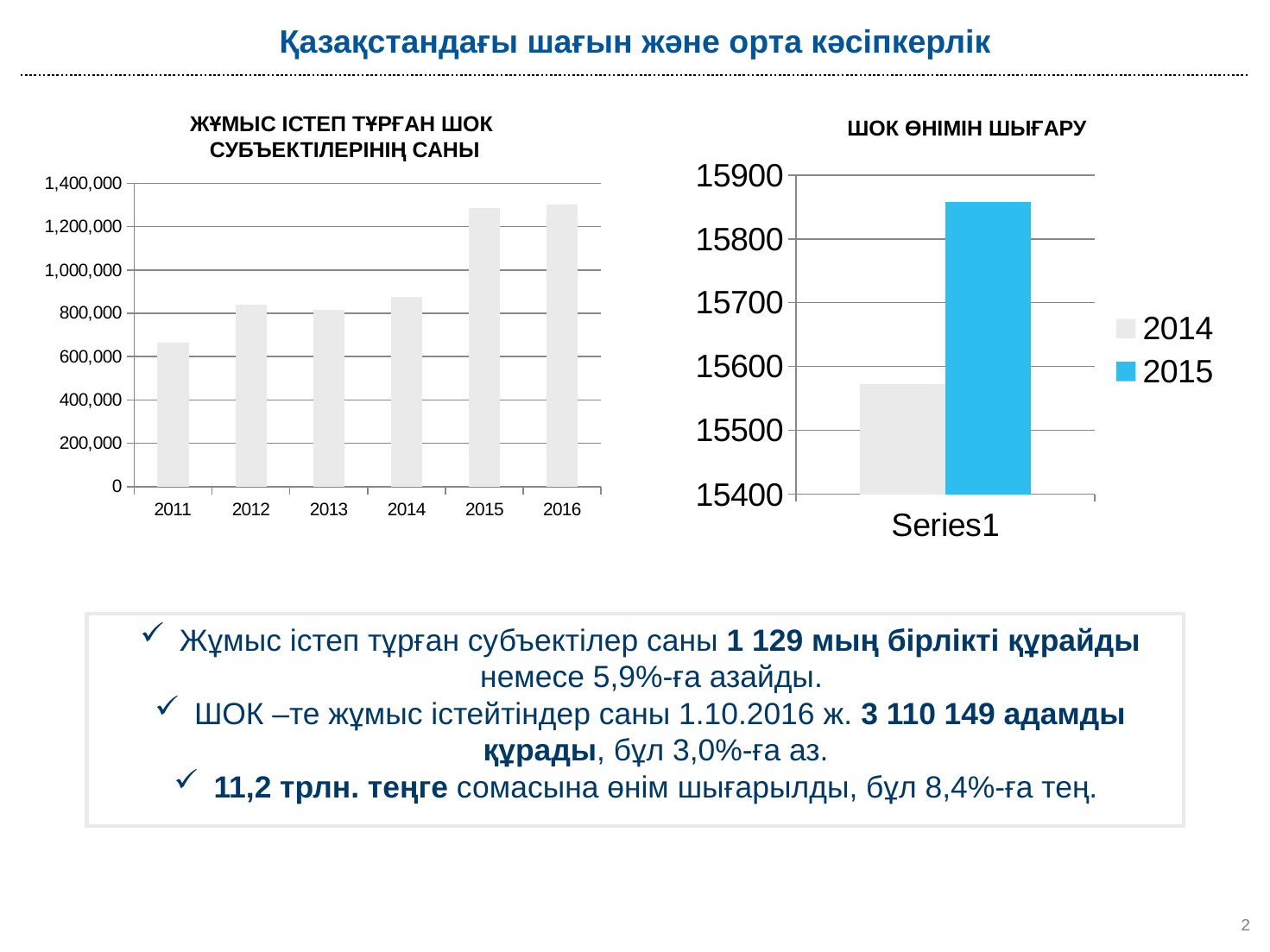
In the chart titled "ЖҰМЫС ІСТЕП ТҰРҒАН ШОК СУБЪЕКТІЛЕРІНІҢ САНЫ", is the value for 2014 greater or less than 1,000,000? less What kind of chart is the chart titled "ЖҰМЫС ІСТЕП ТҰРҒАН ШОК СУБЪЕКТІЛЕРІНІҢ САНЫ"? bar chart In the chart titled "ЖҰМЫС ІСТЕП ТҰРҒАН ШОК СУБЪЕКТІЛЕРІНІҢ САНЫ", how many years are shown on the x axis? 6 In the chart titled "ШОК ӨНІМІН ШЫҒАРУ", which series has the higher value, 2014 or 2015? 2015 In the chart titled "ЖҰМЫС ІСТЕП ТҰРҒАН ШОК СУБЪЕКТІЛЕРІНІҢ САНЫ", is the value for 2015 greater or less than 1,200,000? greater In the chart titled "ШОК ӨНІМІН ШЫҒАРУ", what colour is the bar for 2015? blue In the chart titled "ЖҰМЫС ІСТЕП ТҰРҒАН ШОК СУБЪЕКТІЛЕРІНІҢ САНЫ", is the value for 2011 greater or less than 800,000? less In the chart titled "ЖҰМЫС ІСТЕП ТҰРҒАН ШОК СУБЪЕКТІЛЕРІНІҢ САНЫ", which year has the lowest value? 2011 In the chart titled "ЖҰМЫС ІСТЕП ТҰРҒАН ШОК СУБЪЕКТІЛЕРІНІҢ САНЫ", which is larger, the value for 2012 or the value for 2015? 2015 In the chart titled "ЖҰМЫС ІСТЕП ТҰРҒАН ШОК СУБЪЕКТІЛЕРІНІҢ САНЫ", do the values rise or fall from 2014 to 2015? rise How many series does the legend of the chart titled "ШОК ӨНІМІН ШЫҒАРУ" list? 2